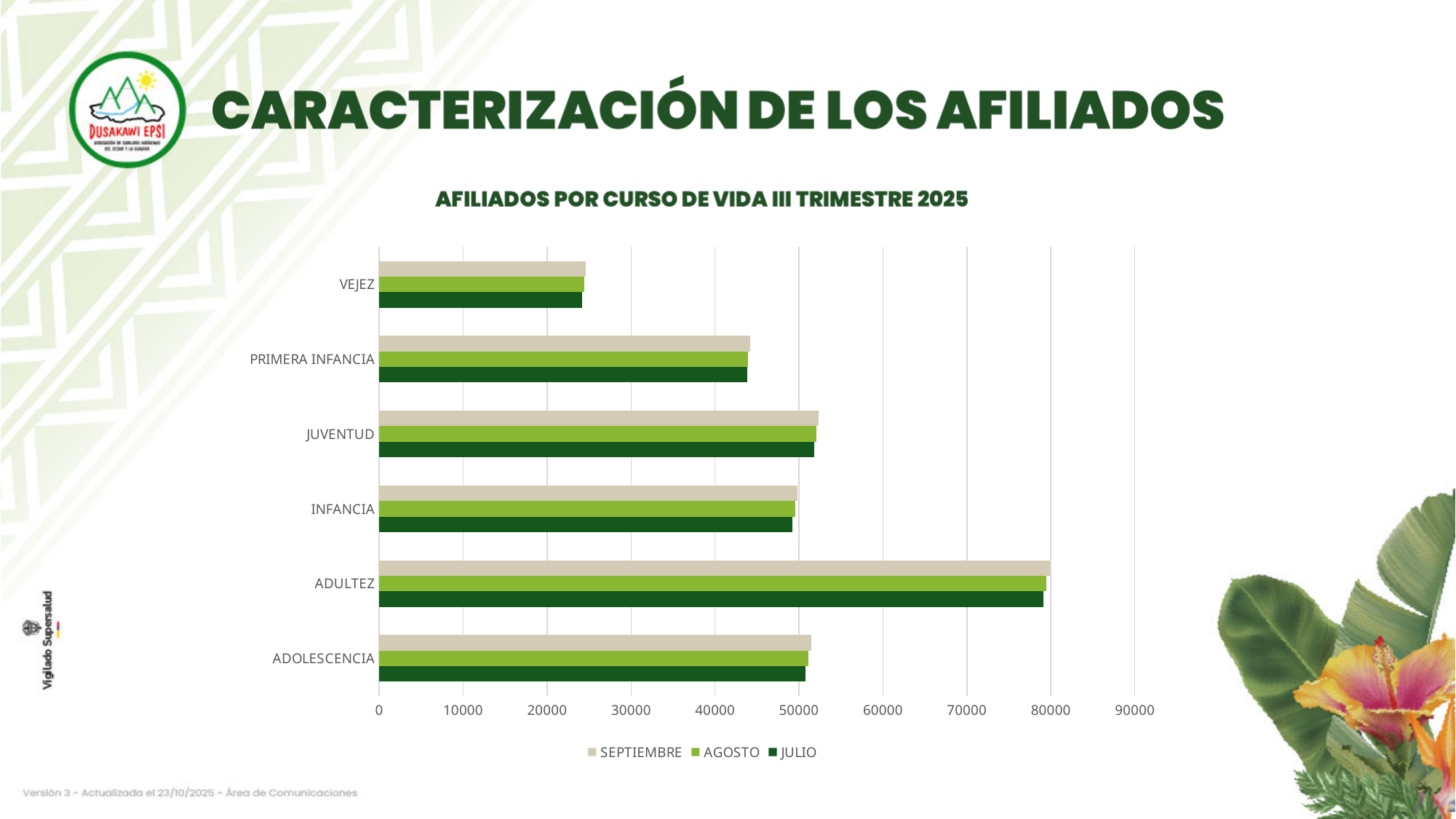
Is the SEPTIEMBRE value for VEJEZ greater or less than 30000? less Is the JULIO value for INFANCIA greater or less than 40000? greater Which category has the highest number of affiliates? ADULTEZ Is the AGOSTO value for PRIMERA INFANCIA greater or less than 50000? less How many series does the chart legend list? 3 What kind of chart is shown on the slide? Bar chart Which category has the lowest number of affiliates? VEJEZ Which category has more affiliates in SEPTIEMBRE, PRIMERA INFANCIA or JUVENTUD? JUVENTUD Which category has more affiliates in JULIO, ADULTEZ or VEJEZ? ADULTEZ What is the title of the chart? AFILIADOS POR CURSO DE VIDA III TRIMESTRE 2025 How many life-course categories are plotted on the chart? 6